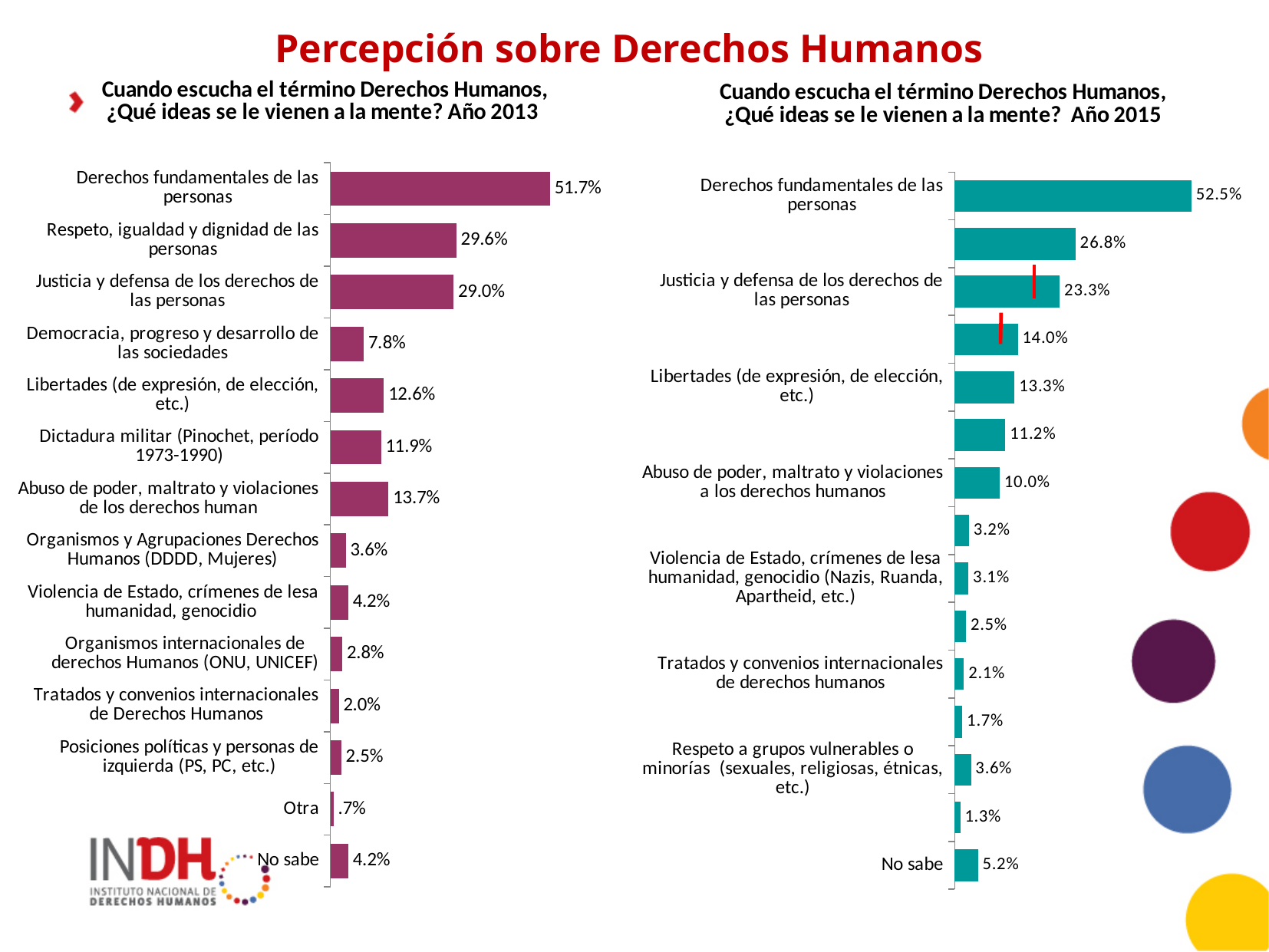
In the 2013 chart (left), which category has the highest value? Derechos fundamentales de las personas What type of chart is used on this slide? Bar chart In the 2013 chart (left), which category has the lowest value? Otra In the 2013 chart (left), what percentage is shown for 'Derechos fundamentales de las personas'? 51.7% In the 2015 chart (right), what percentage is shown for 'Derechos fundamentales de las personas'? 52.5% What is the difference between the 2015 and 2013 values for 'Derechos fundamentales de las personas'? 0.8% In the 2015 chart (right), what percentage is shown for 'Libertades (de expresión, de elección, etc.)'? 13.3% In the 2013 chart (left), which is larger: 'Libertades (de expresión, de elección, etc.)' or 'Dictadura militar (Pinochet, período 1973-1990)'? Libertades (de expresión, de elección, etc.) In the 2015 chart (right), what percentage is shown for 'Justicia y defensa de los derechos de las personas'? 23.3% How many categories are shown in the 2013 chart (left)? 14 In the 2013 chart (left), what is the difference between 'Respeto, igualdad y dignidad de las personas' and 'Justicia y defensa de los derechos de las personas'? 0.6% In the 2015 chart (right), what percentage is shown for 'No sabe'? 5.2%